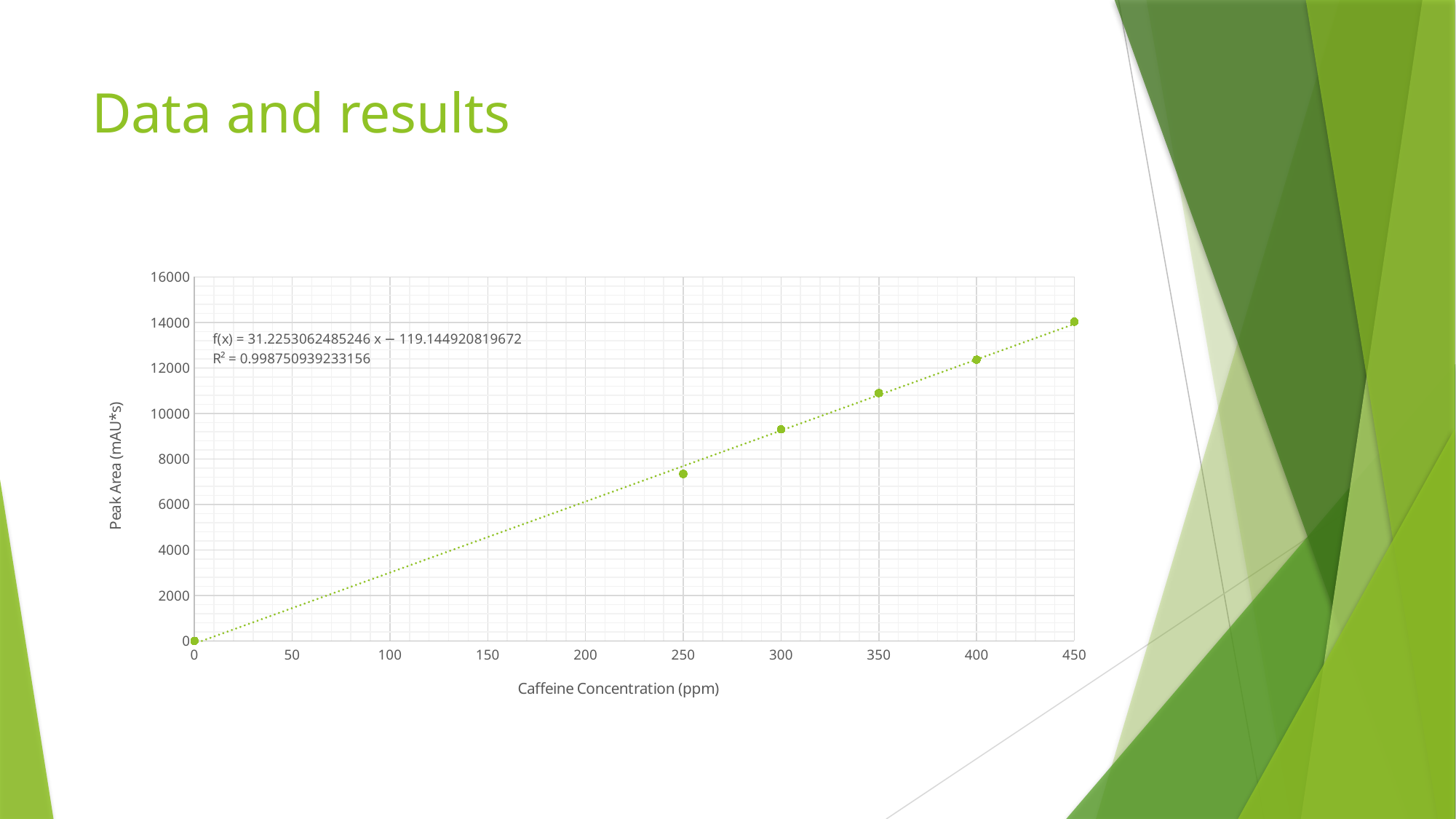
Is the peak area at 250 ppm greater or less than 8000? less Which caffeine concentration has the highest peak area? 450 What is the R² value shown on the chart? 0.998750939233156 What kind of chart is shown on the slide? scatter chart Is the peak area at 450 ppm greater or less than 12000? greater What is the peak area at a caffeine concentration of 0 ppm? 0 What is the title of the y axis? Peak Area (mAU*s) Does the peak area rise or fall as caffeine concentration increases along the x axis? rise Is the peak area at 350 ppm greater or less than 10000? greater Which is larger, the peak area at 300 ppm or at 400 ppm? 400 ppm How many data points are plotted on the chart? 6